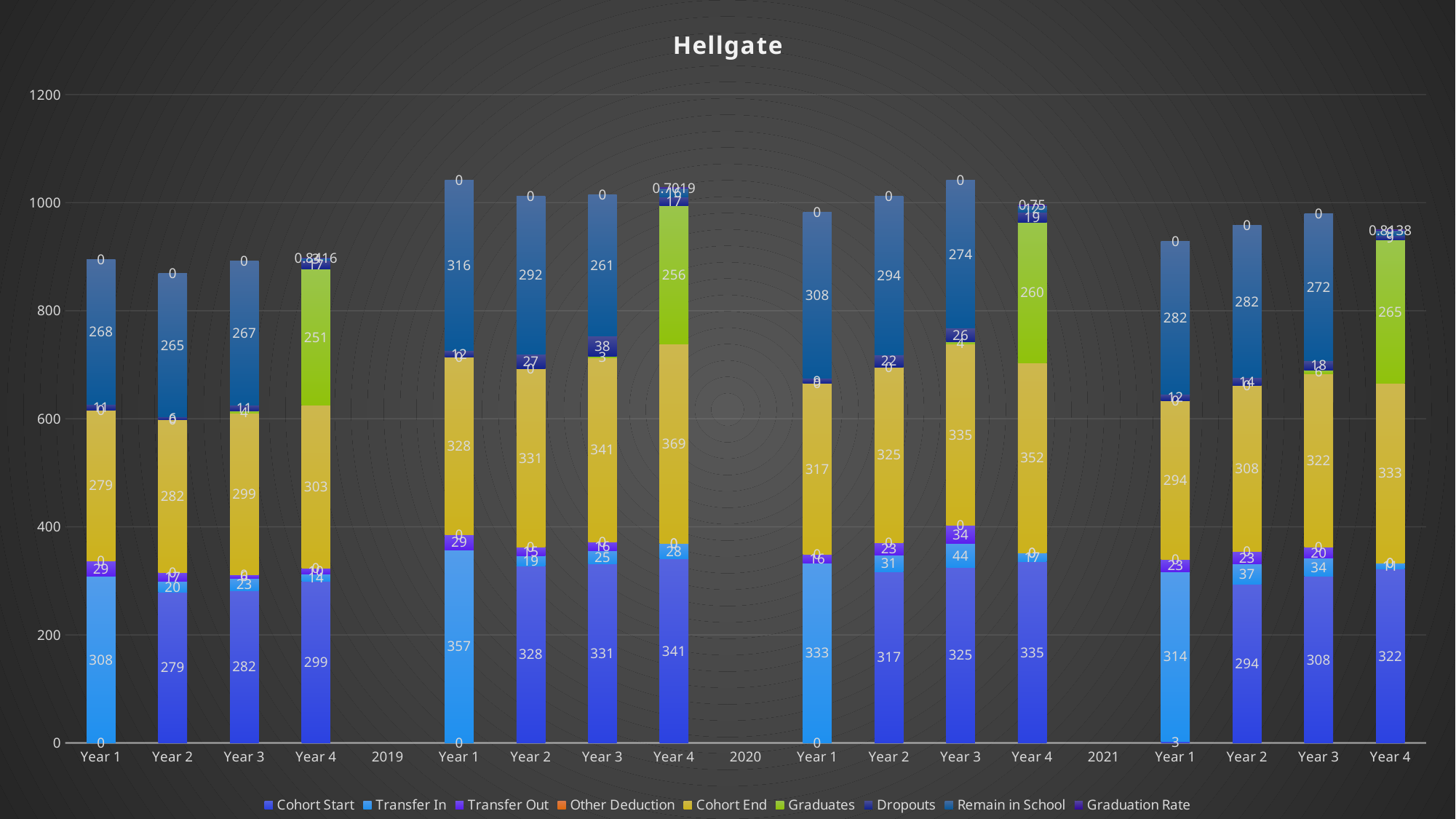
What is the title of the chart? Hellgate What colour represents the Graduates series in the legend? Green What is the Graduates value in the first Year 4 bar (just left of the 2019 label)? 251 What is the Cohort End value in the last Year 4 bar (right of the 2021 label)? 333 What is the difference between the Graduates value in the last Year 4 bar (265) and the first Year 4 bar (251)? 14 Which Year 4 bar has the highest Graduates value? The last Year 4 bar (right of the 2021 label), 265 How many series does the legend list? 9 What is the Cohort End value in the Year 3 bar between the 2020 and 2021 labels? 335 What kind of chart is shown on the slide? Stacked bar chart Which is larger: the Cohort End value in the Year 4 bar between 2019 and 2020, or in the Year 4 bar between 2020 and 2021? The Year 4 bar between 2019 and 2020 (369) Is the total height of the first Year 1 bar (left of the 2019 label) greater or less than 800? greater What is the Remain in School value in the Year 1 bar between the 2019 and 2020 labels? 316